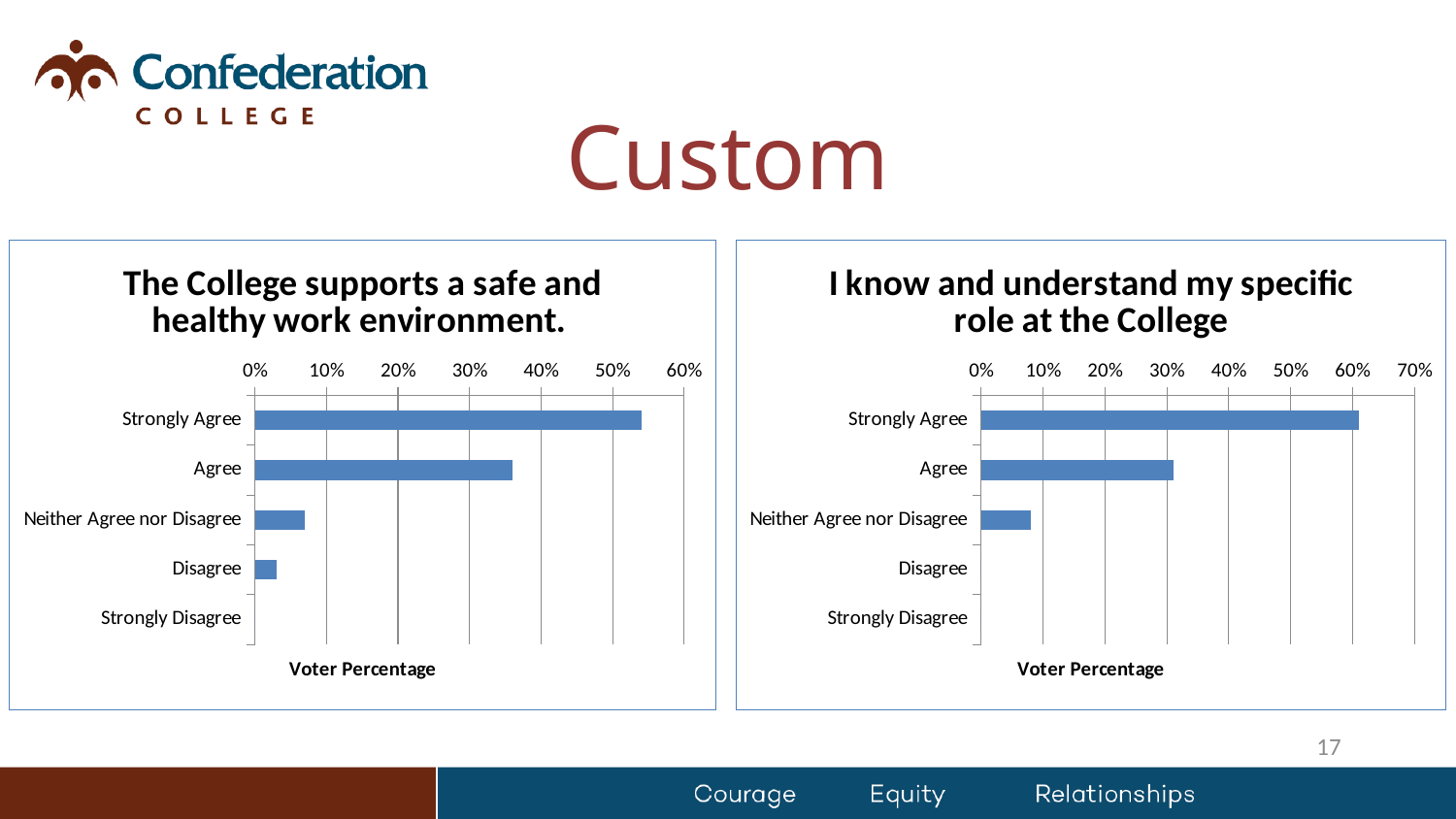
What type of chart is the chart titled "The College supports a safe and healthy work environment."? Bar chart In the chart titled "The College supports a safe and healthy work environment.", is the value for Neither Agree nor Disagree greater or less than 10%? less How many categories are shown in the chart titled "I know and understand my specific role at the College"? 5 In the chart titled "The College supports a safe and healthy work environment.", is the value for Agree greater or less than 40%? less In the chart titled "The College supports a safe and healthy work environment.", which category has the highest voter percentage? Strongly Agree In the chart titled "I know and understand my specific role at the College", is the value for Agree greater or less than 40%? less In the chart titled "The College supports a safe and healthy work environment.", which category has the lowest voter percentage? Strongly Disagree In the chart titled "I know and understand my specific role at the College", which is larger, Strongly Agree or Neither Agree nor Disagree? Strongly Agree In the chart titled "The College supports a safe and healthy work environment.", which is larger, Agree or Disagree? Agree In the chart titled "I know and understand my specific role at the College", which category has the highest voter percentage? Strongly Agree